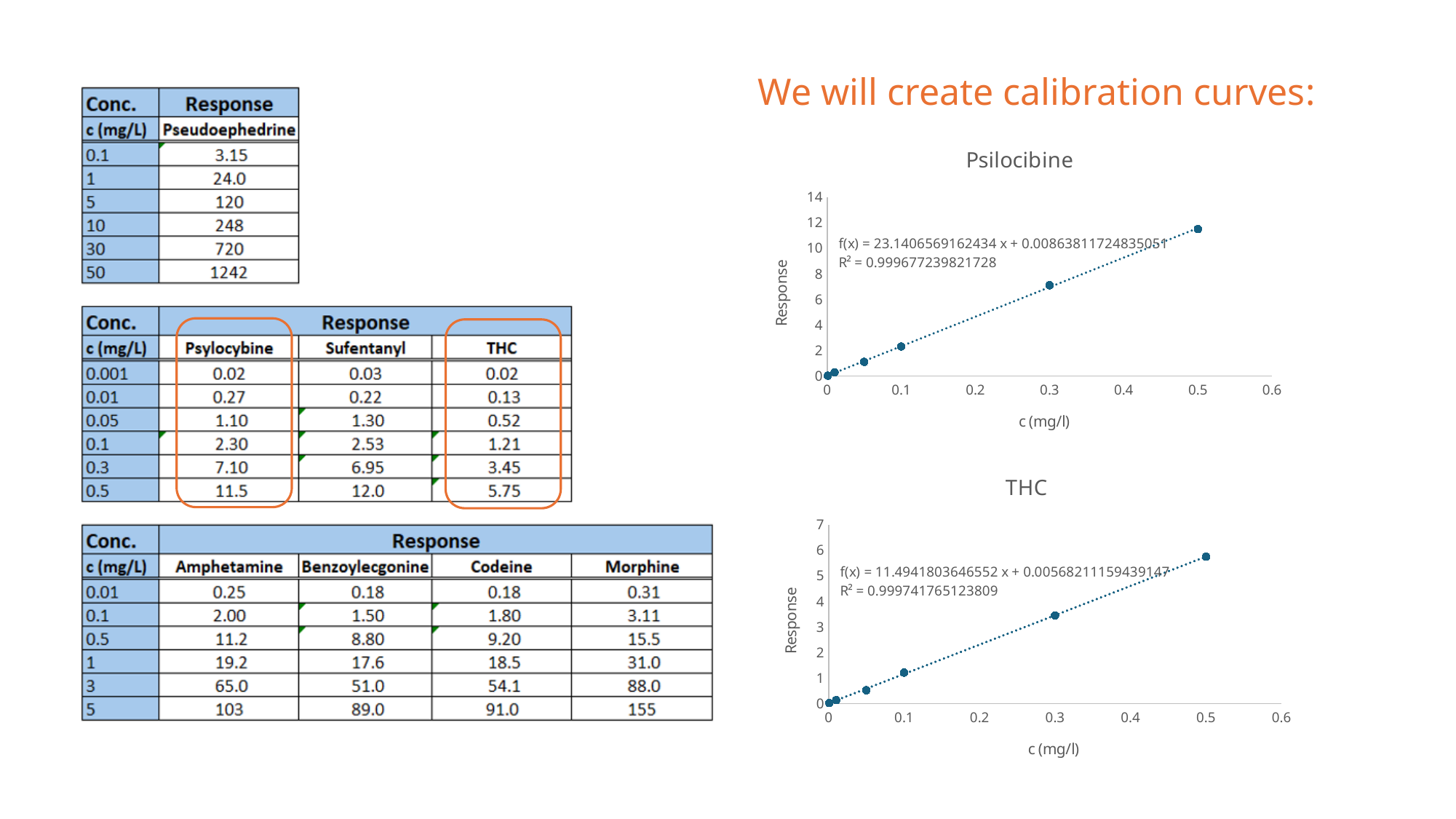
In the Psilocibine chart, is the response at 0.5 mg/l greater or less than 10? greater In the THC chart, does the response rise or fall as concentration increases along the x axis? rise What R² value is printed on the THC chart? 0.999741765123809 In the THC chart, is the response at 0.3 mg/l greater or less than 4? less In the THC chart, is the response at 0.1 mg/l greater or less than 2? less What kind of chart is the THC chart? scatter chart In the Psilocibine chart, at which concentration is the response highest? 0.5 In the THC chart, which has the larger response: the point at 0.3 mg/l or the point at 0.5 mg/l? 0.5 mg/l What kind of chart is the Psilocibine chart? scatter chart In the Psilocibine chart, does the response rise or fall as concentration increases along the x axis? rise